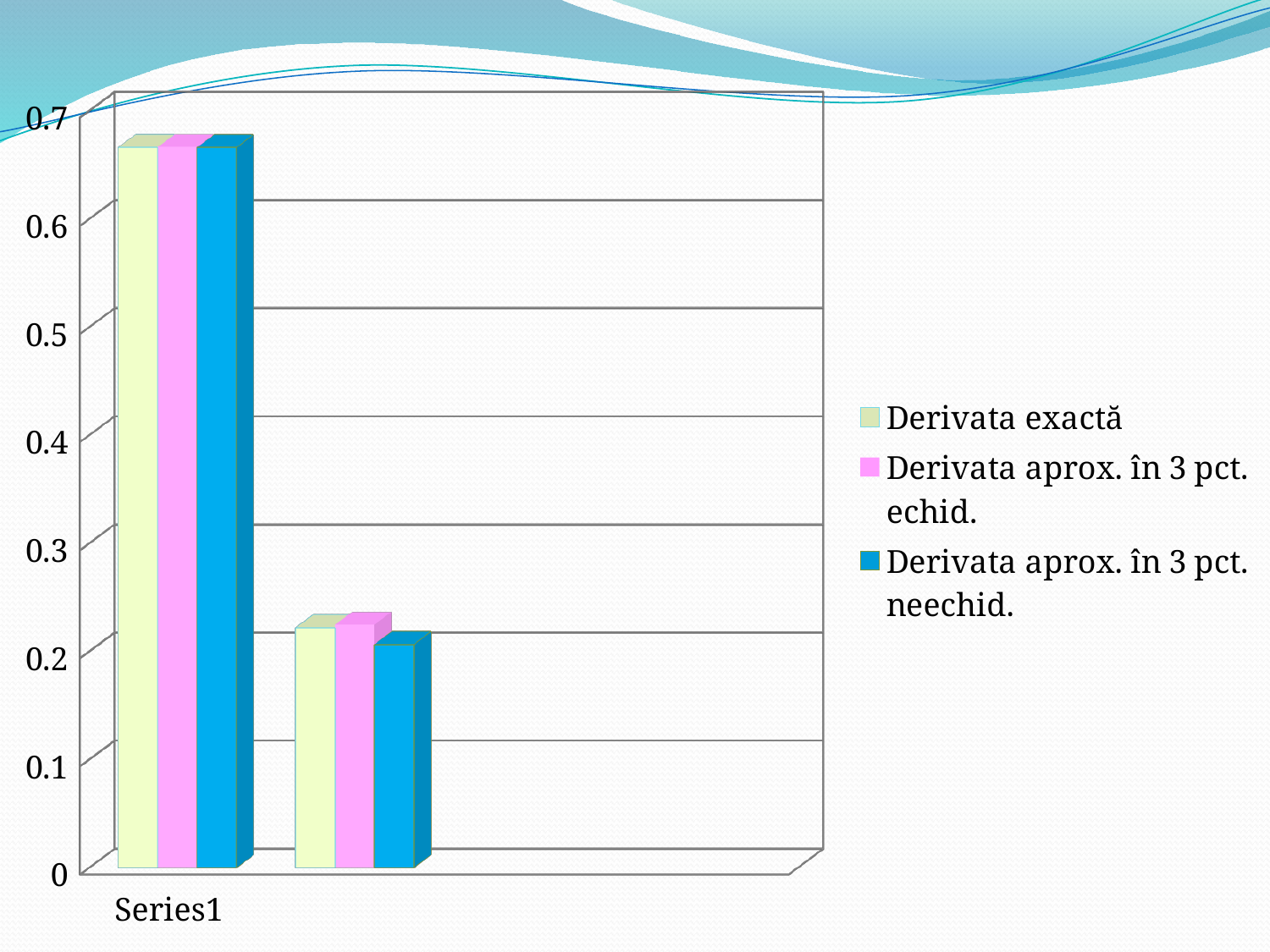
Is the value for Derivata aprox. în 3 pct. neechid. in Series1 greater or less than 0.7? less Is the value for Derivata exactă in Series1 greater or less than 0.4? greater What kind of chart is shown on the slide? bar chart What colour are the bars for Derivata aprox. în 3 pct. neechid.? blue Is the value for Derivata exactă in Series1 greater or less than 0.6? greater How many series does the legend list? 3 What is the name of the first legend entry? Derivata exactă Do the bar heights rise or fall from left to right along the x axis? fall What is the highest value shown on the vertical axis? 0.7